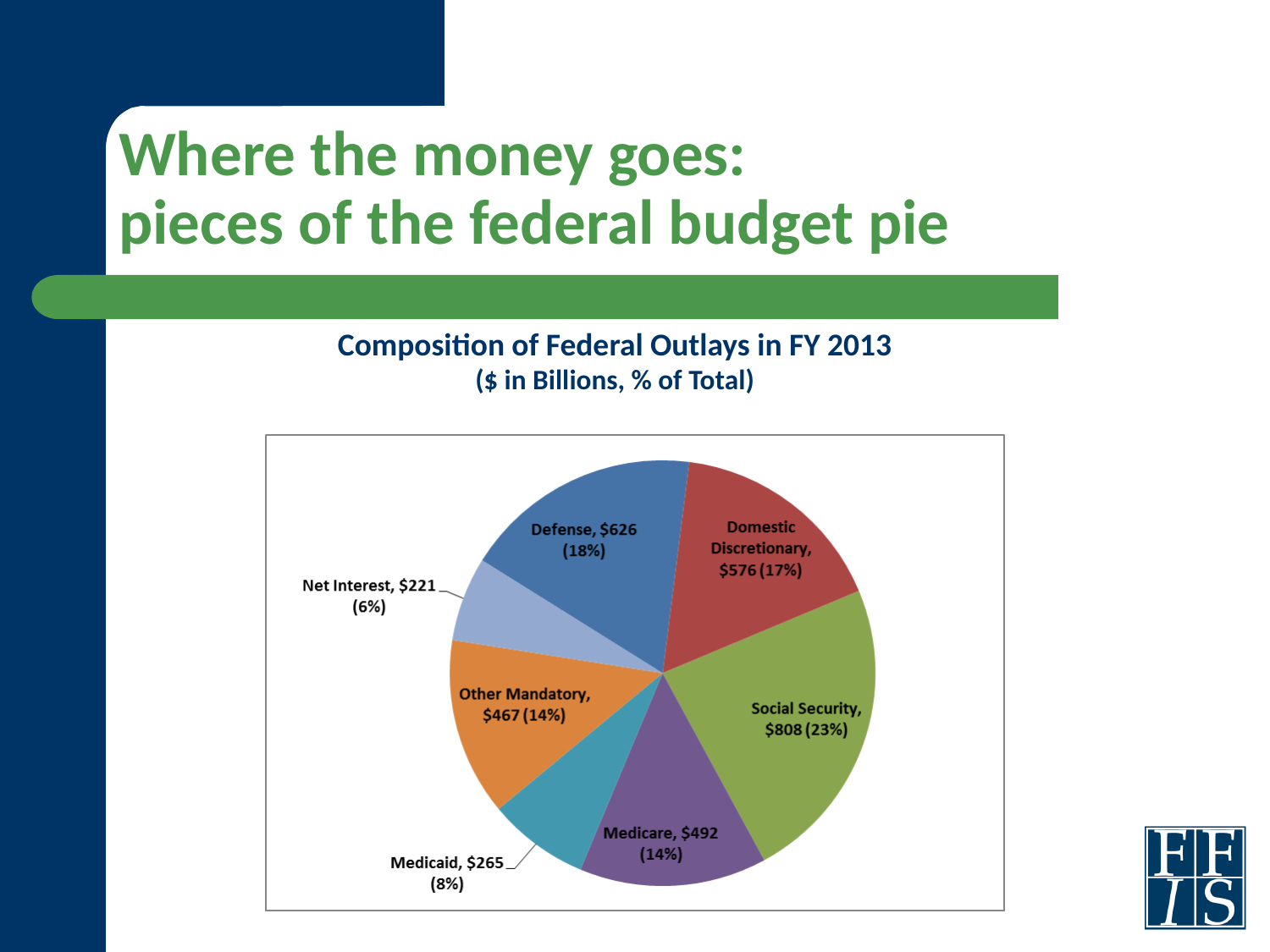
Which is larger, Defense or Domestic Discretionary? Defense Which category has the largest slice of the pie? Social Security What type of chart is shown on the slide? pie chart What is the value for Social Security? $808 What is the value for Other Mandatory? $467 How many slices does the pie chart have? 7 What share of the pie does Defense represent? 18% What is the difference between the values for Social Security and Medicare? $316 What is the value for Net Interest? $221 What is the title of the chart? Composition of Federal Outlays in FY 2013 What share of the pie does Medicaid represent? 8% Which category has the smallest slice of the pie? Net Interest